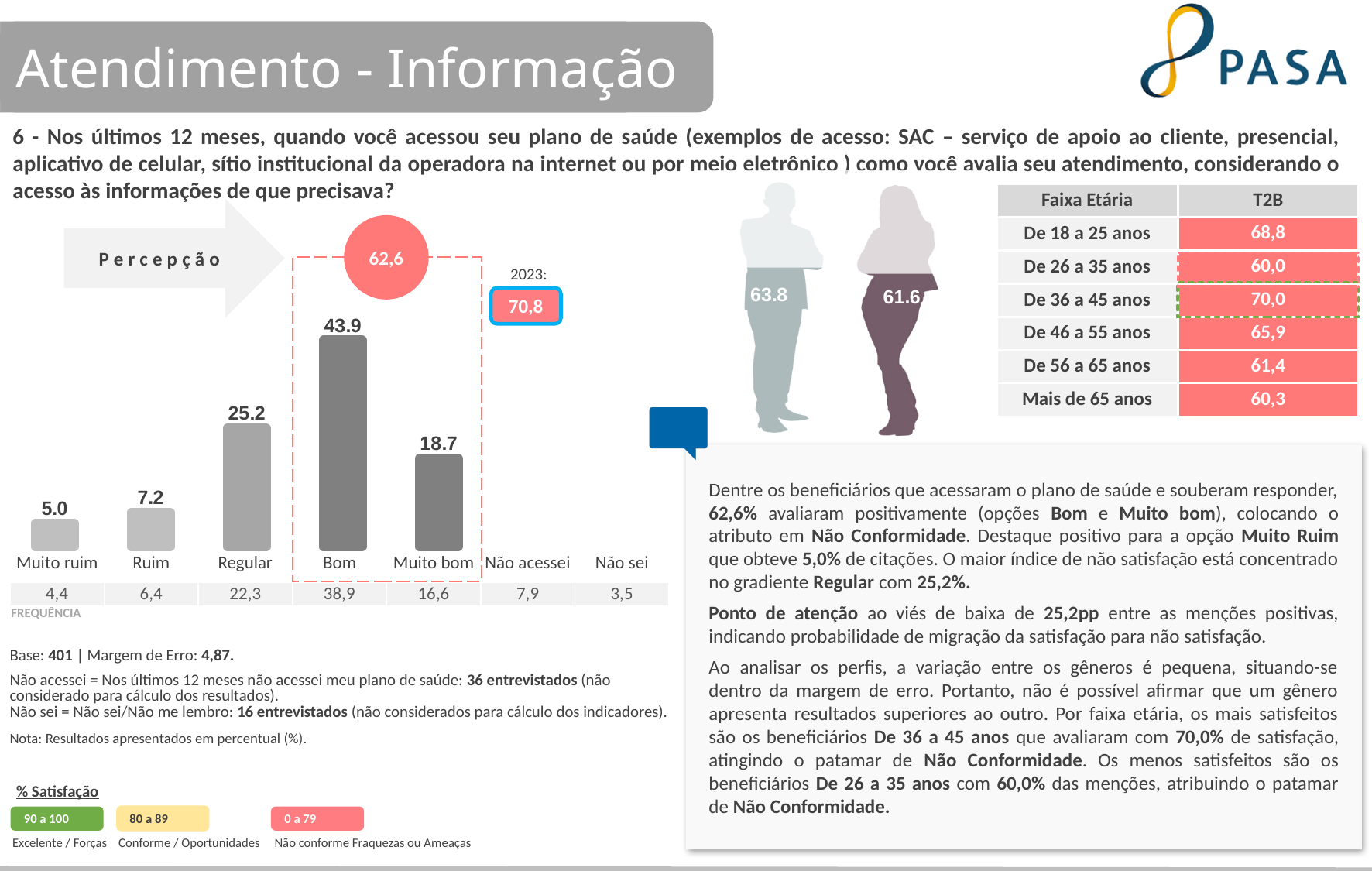
What type of chart is used to show the evaluation categories (Muito ruim to Muito bom)? Bar chart What is the value shown for the 'Muito ruim' bar in the bar chart? 5.0 What is the value shown for the 'Ruim' bar in the bar chart? 7.2 What is the difference between the 'Bom' and 'Muito bom' values in the bar chart? 25.2 Which is larger in the bar chart, the value for 'Regular' or the value for 'Muito bom'? Regular What value is shown in the box labelled '2023:' next to the bar chart? 70,8 How many bars are plotted in the bar chart? 5 What is the combined value of the 'Bom' and 'Muito bom' bars, as shown in the circle above the dashed box? 62,6 Which category has the highest bar in the bar chart? Bom Which category has the lowest bar in the bar chart? Muito ruim What is the value shown for the 'Bom' bar in the bar chart? 43.9 What is the value shown for the 'Regular' bar in the bar chart? 25.2